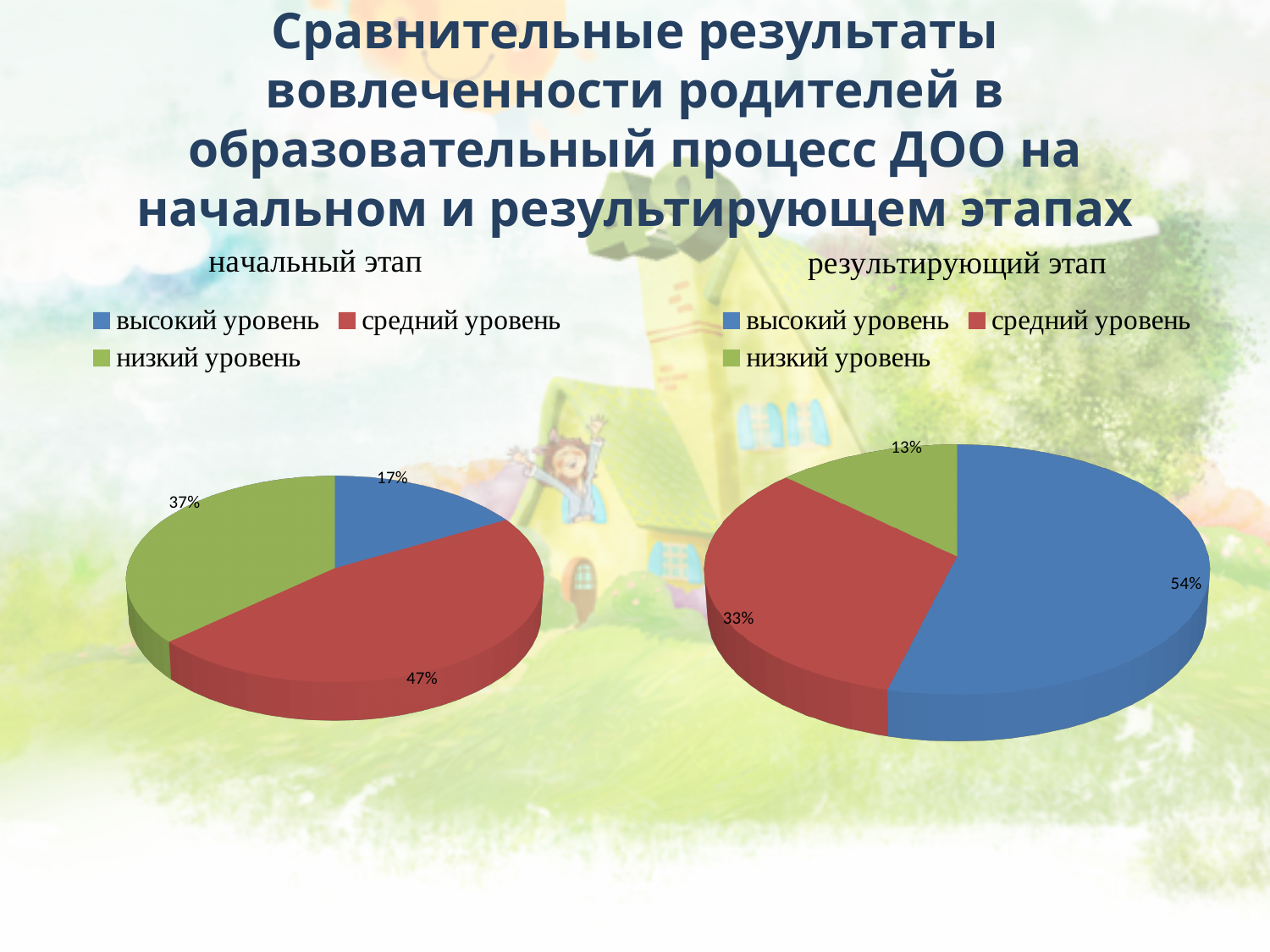
In the 'результирующий этап' chart, what is the difference between 'средний уровень' and 'низкий уровень'? 20% In the 'начальный этап' chart, which category has the largest share? средний уровень Which is larger: 'низкий уровень' in the 'начальный этап' chart or 'низкий уровень' in the 'результирующий этап' chart? начальный этап How many entries does the legend of the 'начальный этап' chart list? 3 In the 'начальный этап' chart, which category has the smallest share? высокий уровень In the 'результирующий этап' chart, what is the value for 'высокий уровень'? 54% In the 'результирующий этап' chart, which category has the smallest share? низкий уровень What type of chart is the 'результирующий этап' chart? pie chart In the 'начальный этап' chart, what is the value for 'высокий уровень'? 17% In the 'начальный этап' chart, what is the value for 'средний уровень'? 47% What is the difference between 'высокий уровень' in the 'результирующий этап' chart and 'высокий уровень' in the 'начальный этап' chart? 37% In the 'результирующий этап' chart, what is the value for 'низкий уровень'? 13%